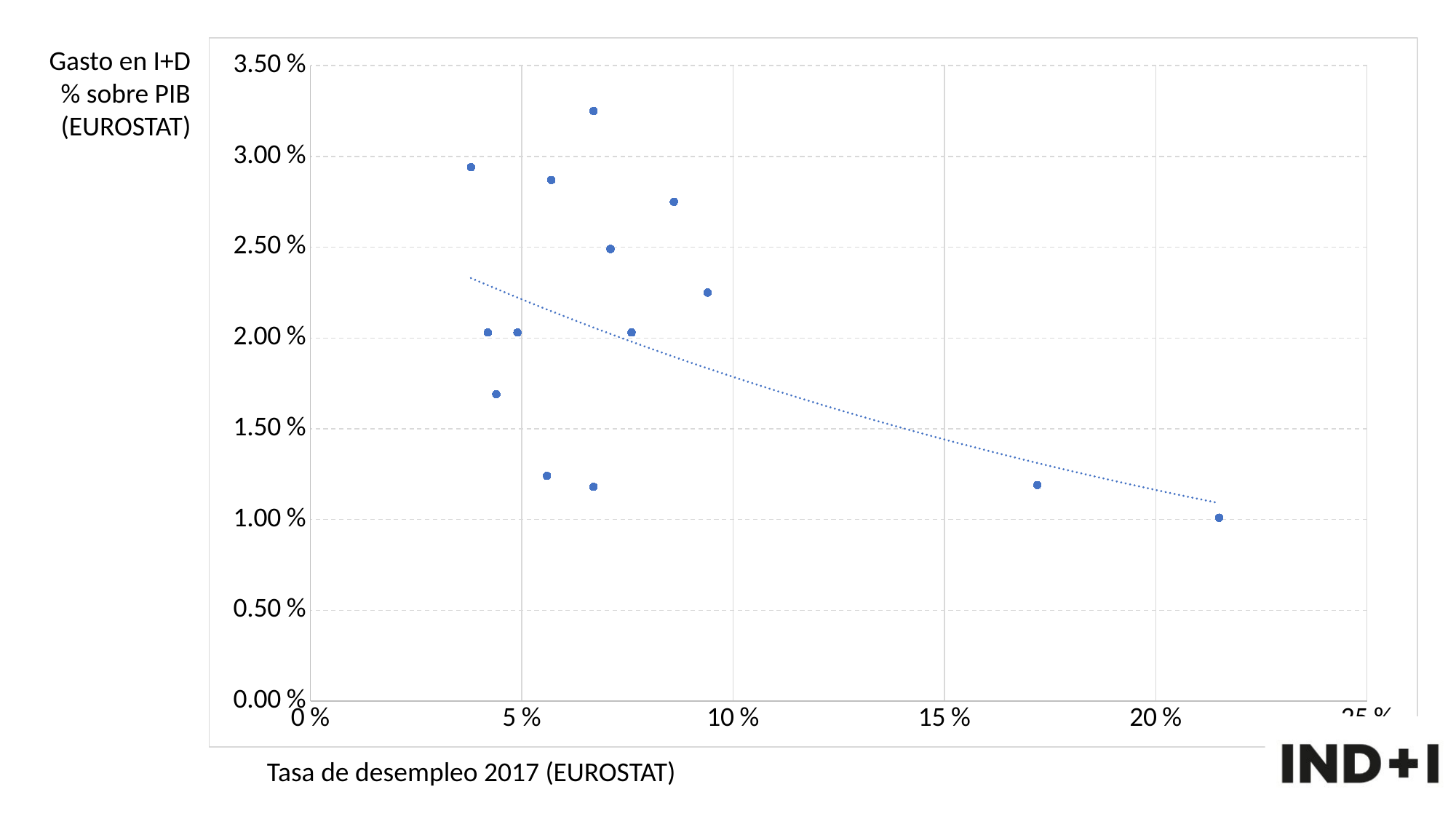
How many points have R&D spending above 3.00%? 1 Is the R&D spending of the point with the lowest unemployment rate greater or less than 2.50%? greater What kind of chart is shown on the slide? scatter chart How many data points are plotted on the chart? 14 How many points have an unemployment rate greater than 15%? 2 Is the R&D spending value of the highest point on the chart greater or less than 3.00%? greater Is the R&D spending value of the point with the highest unemployment rate greater or less than 1.50%? less Does the dotted trend line rise or fall as the unemployment rate increases along the x axis? fall What is the label of the horizontal axis? Tasa de desempleo 2017 (EUROSTAT) What is the highest value shown on the vertical axis? 3.50 % What is the label of the vertical axis? Gasto en I+D % sobre PIB (EUROSTAT)